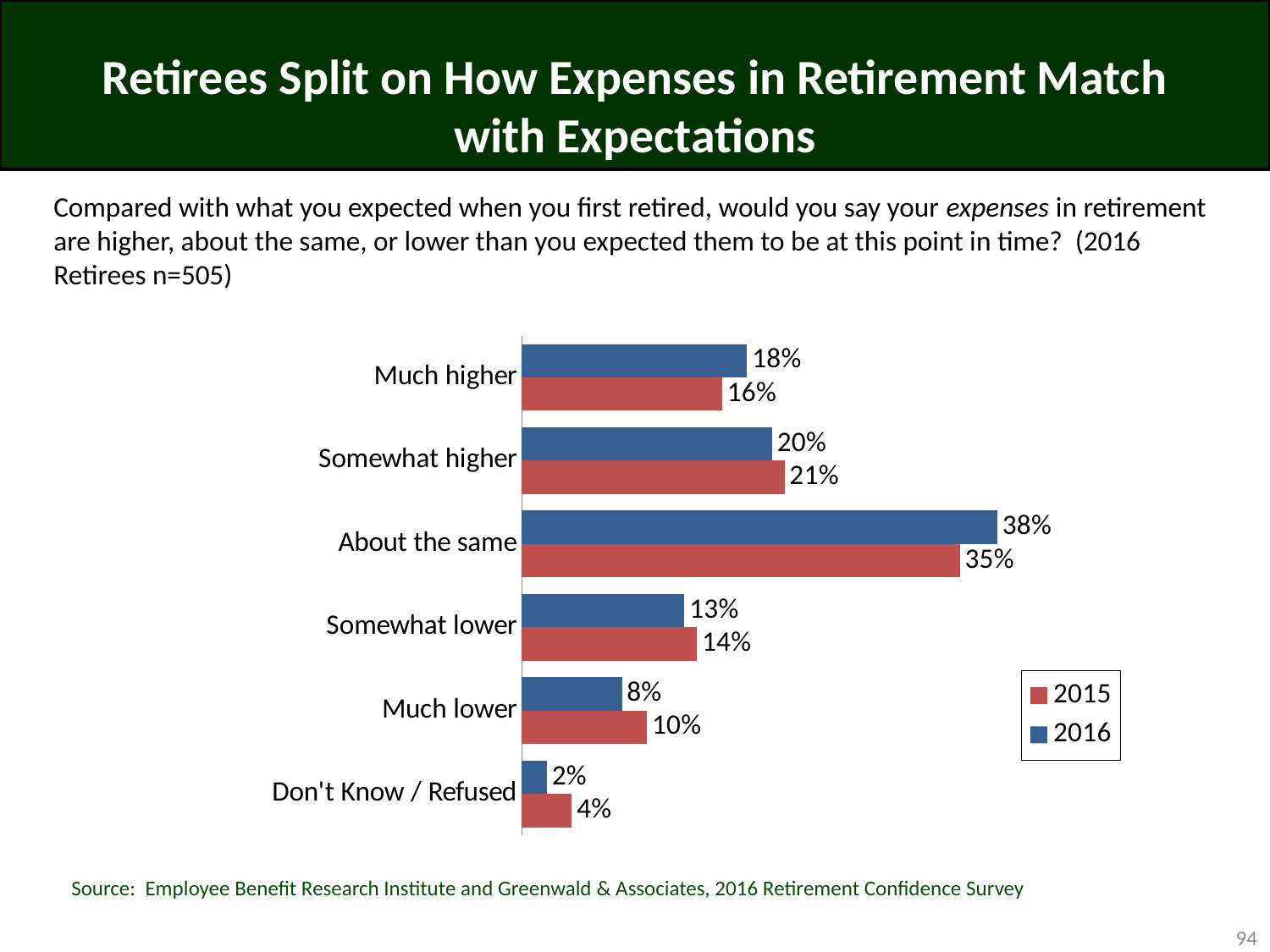
Which is larger for "Somewhat higher": the 2015 value or the 2016 value? 2015 How many series does the legend list? 2 Which category has the highest 2016 value? About the same What is the 2016 value for "About the same"? 38% What is the 2016 value for "Don't Know / Refused"? 2% Which category has the lowest 2015 value? Don't Know / Refused What is the 2015 value for "Much lower"? 10% What kind of chart is shown on the slide? Bar chart What is the difference between the 2016 and 2015 values for "About the same"? 3% Which colour represents the 2016 series in the legend? Blue Which is larger for "Much higher": the 2015 value or the 2016 value? 2016 How many categories are shown on the chart? 6